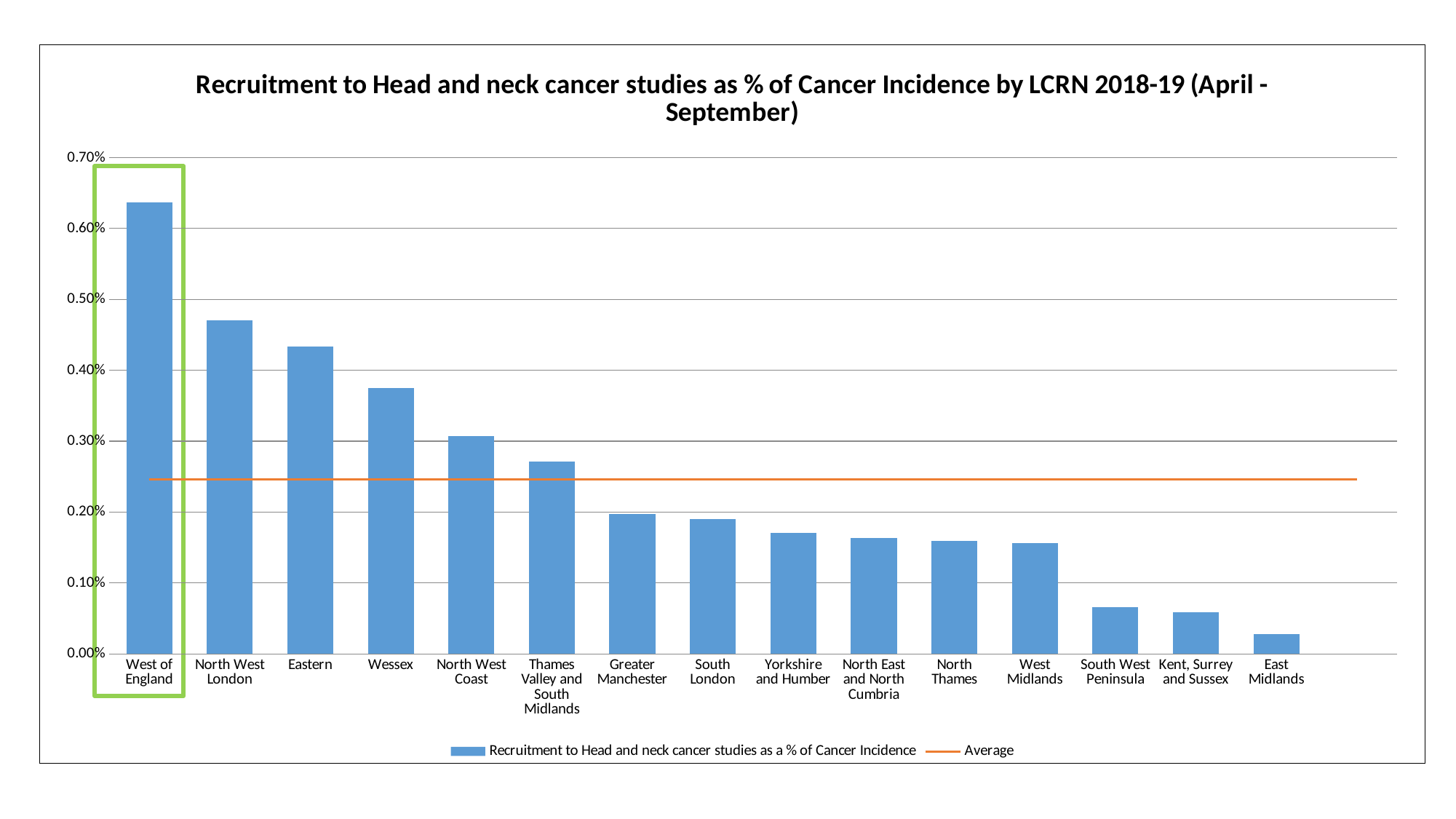
Which is larger, the value for Eastern or the value for North West Coast? Eastern What kind of chart is shown on the slide? bar chart What does the orange horizontal line represent according to the legend? Average How many LCRNs are shown on the x axis? 15 How many series does the legend list? 2 Is the value for North West London greater or less than 0.40%? greater Is the value for Wessex greater or less than 0.40%? less Is the value for West of England greater or less than 0.60%? greater Which LCRN has the lowest recruitment to head and neck cancer studies as a % of cancer incidence? East Midlands Do the bar values rise or fall moving from left to right along the x axis? fall Which LCRN has the highest recruitment to head and neck cancer studies as a % of cancer incidence? West of England